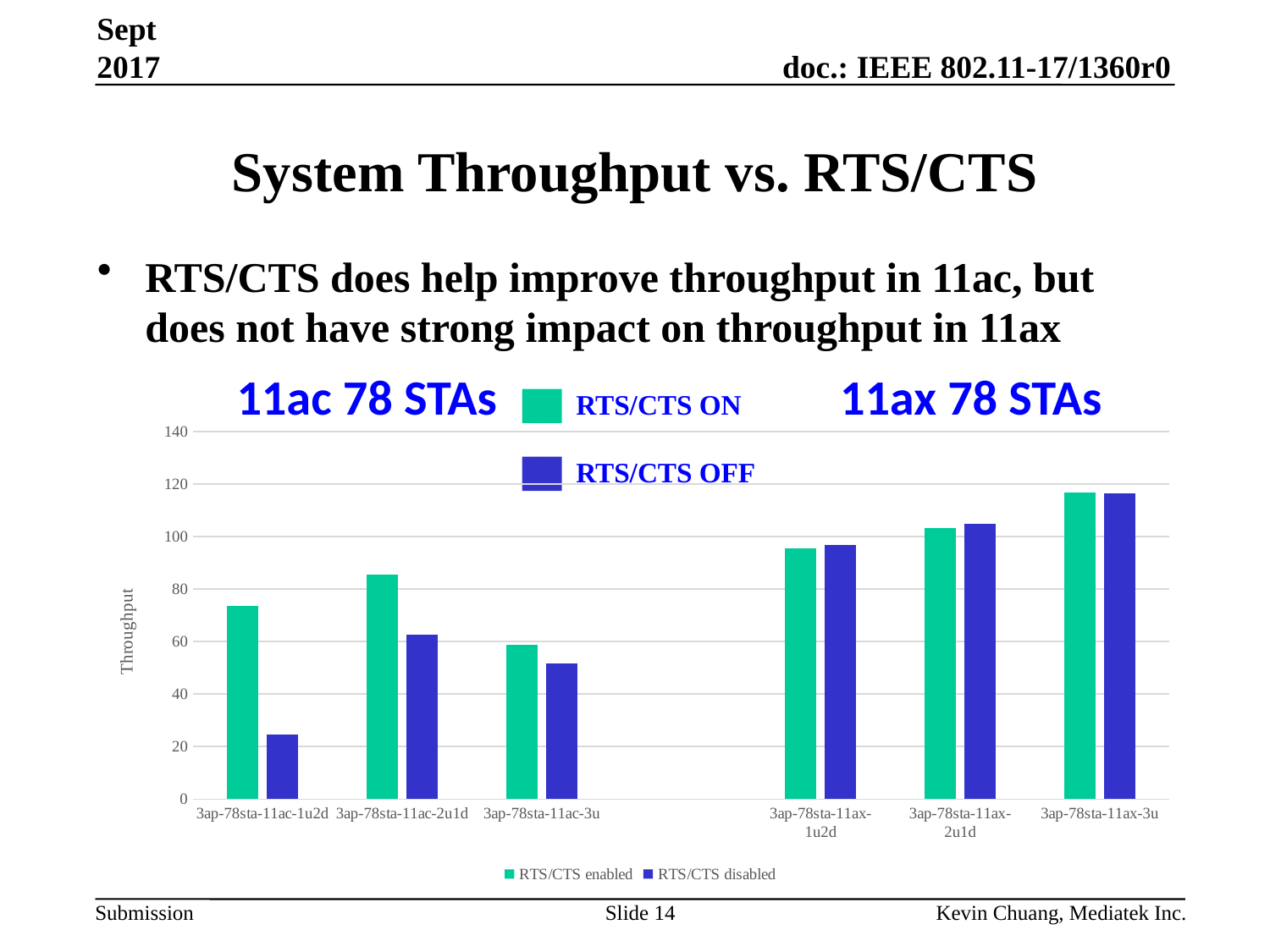
Which category has the highest RTS/CTS enabled value? 3ap-78sta-11ax-3u What is the label of the y axis of the chart? Throughput How many series does the chart legend list? 2 Which category has the lowest RTS/CTS disabled value? 3ap-78sta-11ac-1u2d What kind of chart is shown on the slide? bar chart Is the RTS/CTS enabled value for 3ap-78sta-11ax-3u greater or less than 100? greater For 3ap-78sta-11ac-1u2d, which is larger: the RTS/CTS enabled value or the RTS/CTS disabled value? RTS/CTS enabled Is the RTS/CTS disabled value for 3ap-78sta-11ac-1u2d greater or less than 40? less Across the three 11ax categories from left to right, do the RTS/CTS enabled values rise or fall? rise Is the RTS/CTS enabled value for 3ap-78sta-11ac-2u1d greater or less than 80? greater Which is larger: the RTS/CTS enabled value for 3ap-78sta-11ac-3u or the RTS/CTS enabled value for 3ap-78sta-11ax-1u2d? 3ap-78sta-11ax-1u2d How many labeled categories are shown on the x axis of the chart? 6